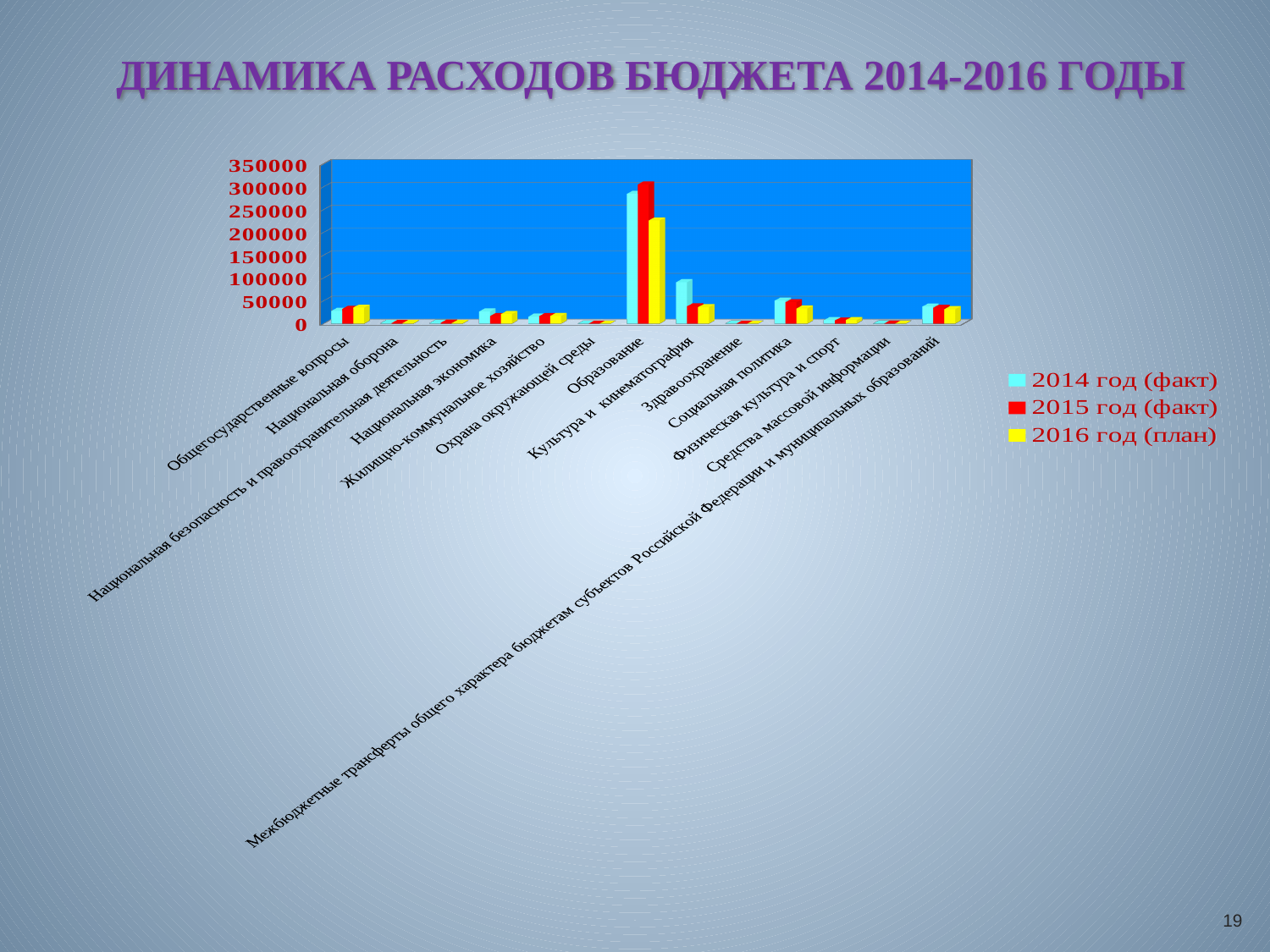
Is the 2014 год (факт) value for Культура и кинематография greater or less than 50000? greater Is the 2015 год (факт) value for Национальная оборона greater or less than 50000? less What is the title of the slide containing the chart? ДИНАМИКА РАСХОДОВ БЮДЖЕТА 2014-2016 ГОДЫ Is the 2015 год (факт) value for Образование greater or less than 250000? greater Which category has the highest values in the chart? Образование How many series does the legend list? 3 What kind of chart is shown on the slide? Bar chart Which colour represents the 2016 год (план) series in the legend? Yellow For Образование, which is larger: the 2015 год (факт) value or the 2016 год (план) value? 2015 год (факт) For Образование, which is larger: the 2014 год (факт) value or the 2015 год (факт) value? 2015 год (факт) How many categories are shown on the x axis of the chart? 13